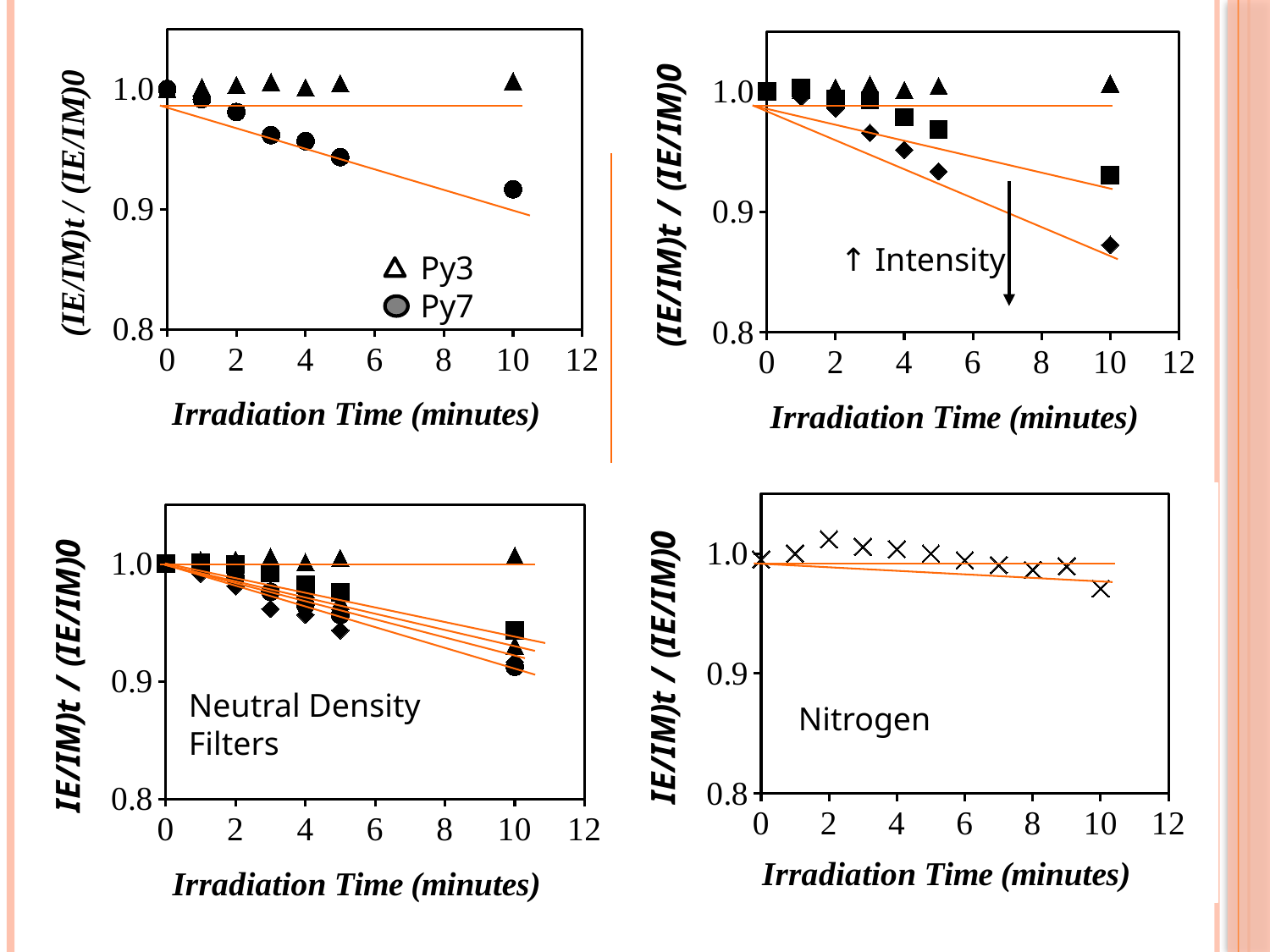
In the bottom-right (Nitrogen) chart, how many data points are plotted? 11 In the top-left chart, how many series does the legend list? 2 In the top-right chart, is the square-marker value at 10 minutes greater or less than 0.9? greater What text label appears inside the bottom-left chart? Neutral Density Filters In the top-left chart, do the Py7 values rise or fall as irradiation time increases? fall In the top-right chart, is the diamond-marker value at 10 minutes greater or less than 0.9? less In the bottom-right (Nitrogen) chart, is the value at 10 minutes greater or less than 0.9? greater In the top-left chart, what are the two legend entries? Py3 and Py7 In the top-right chart, which marker series has the lowest value at 10 minutes? diamonds In the top-left chart, at 10 minutes, which series has the larger value, Py3 or Py7? Py3 What kind of chart is the top-left chart? scatter chart